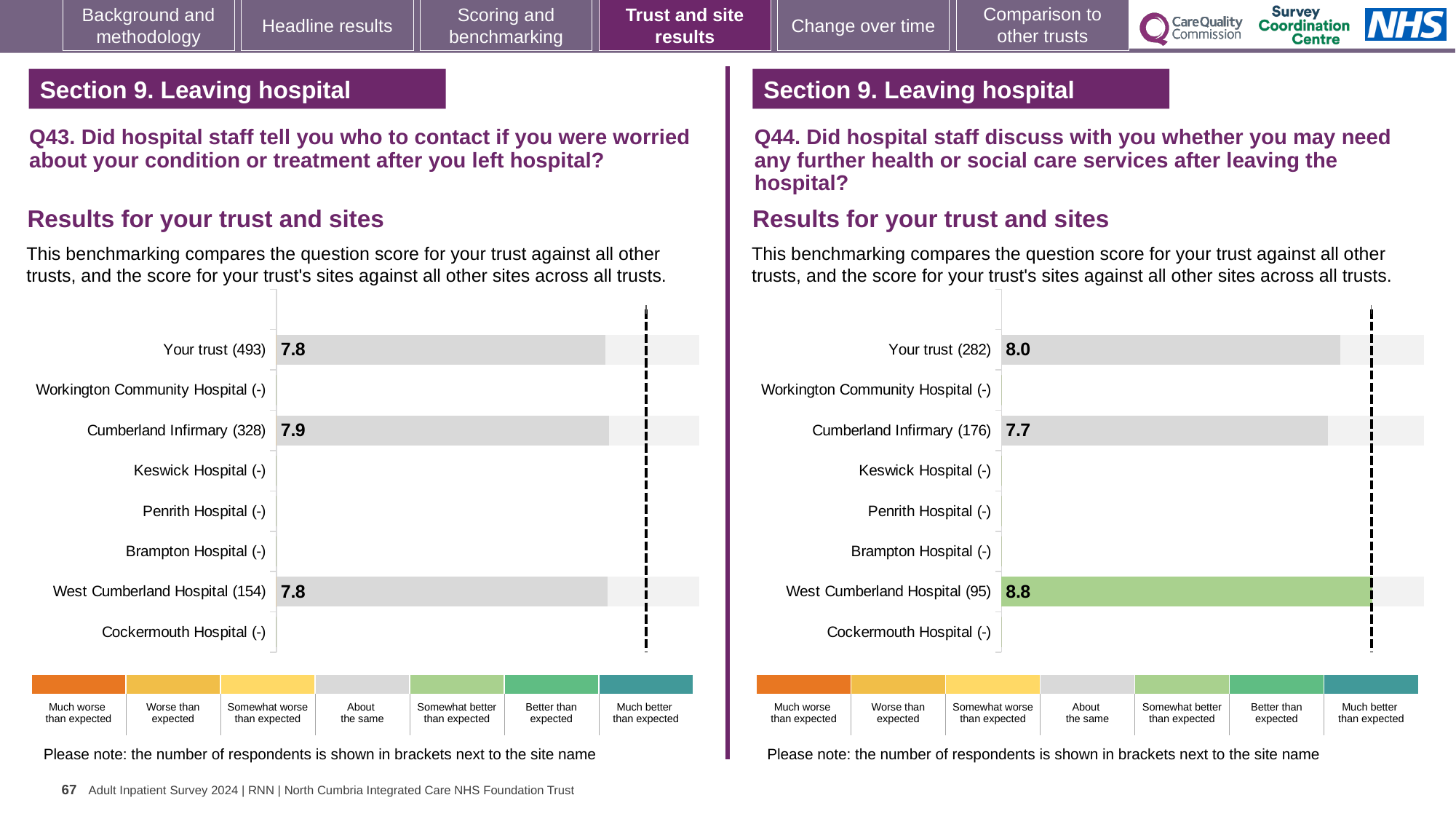
In the Q44 chart on the right, what is the score for West Cumberland Hospital? 8.8 In the Q44 chart on the right, which row with a plotted score has the lowest score? Cumberland Infirmary In the Q43 chart on the left, what is the score for Your trust? 7.8 How many site or trust rows are listed on the vertical axis of the Q43 chart on the left? 8 In the Q44 chart on the right, which row's bar is coloured green (Somewhat better than expected)? West Cumberland Hospital What kind of chart is used in the Q44 chart on the right? Bar chart In the Q44 chart on the right, which is larger: the score for Your trust or the score for Cumberland Infirmary? Your trust In the Q44 chart on the right, which site or trust row has the highest score? West Cumberland Hospital In the Q44 chart on the right, what is the difference between the West Cumberland Hospital score and the Your trust score? 0.8 In the Q43 chart on the left, what is the difference between the Cumberland Infirmary score and the West Cumberland Hospital score? 0.1 In the Q43 chart on the left, what is the score for Cumberland Infirmary? 7.9 In the Q44 chart on the right, what is the score for Cumberland Infirmary? 7.7